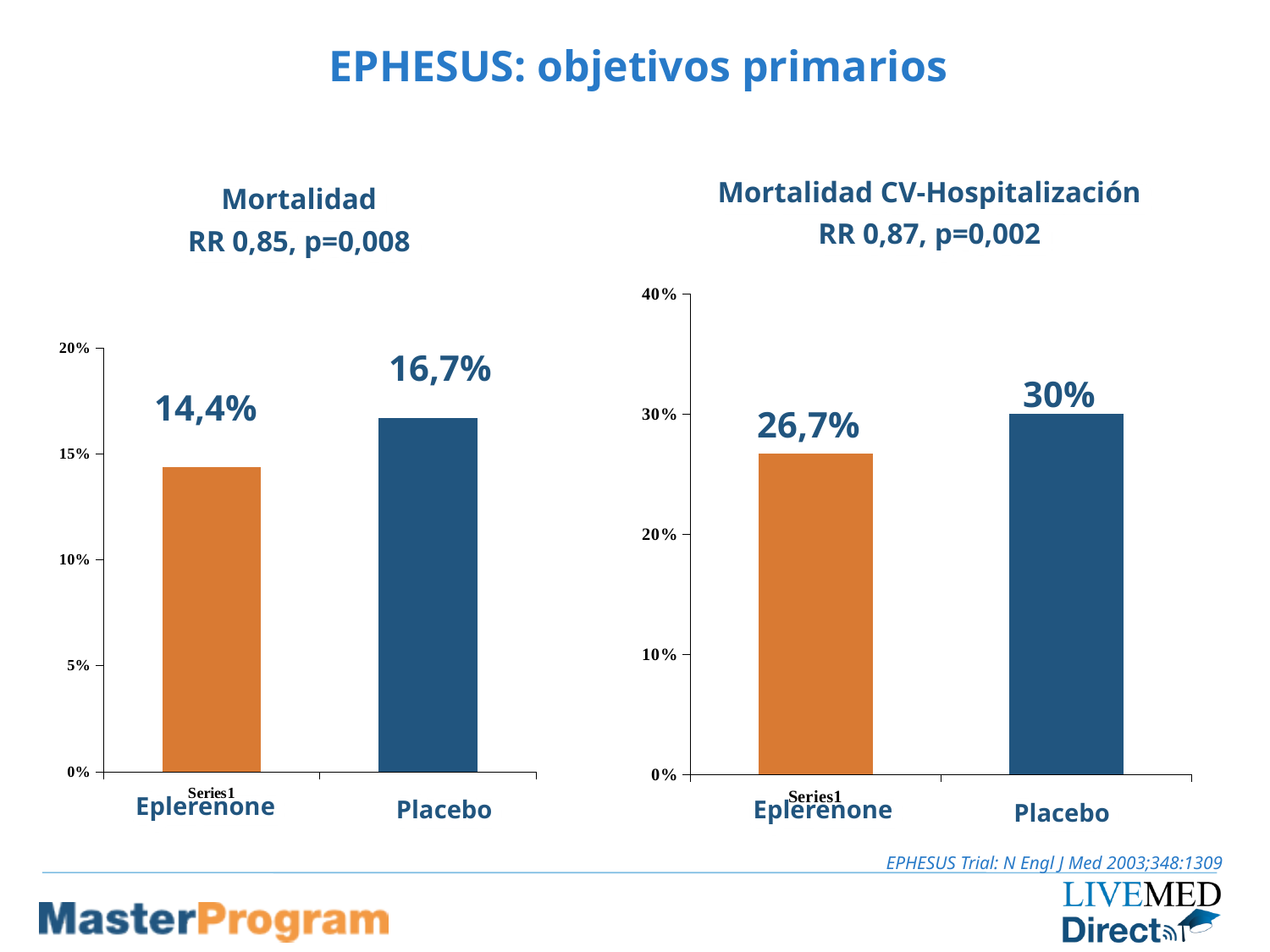
In the Mortalidad chart on the left, what is the difference between the Placebo and Eplerenone values? 2,3% In the Mortalidad CV-Hospitalización chart on the right, which category has the lower value? Eplerenone In the Mortalidad CV-Hospitalización chart on the right, what is the value for Eplerenone? 26,7% How many bars are shown in the Mortalidad chart on the left? 2 What type of chart is the Mortalidad CV-Hospitalización chart on the right? bar chart In the Mortalidad chart on the left, what is the value for Eplerenone? 14,4% In the Mortalidad CV-Hospitalización chart on the right, what is the difference between the Placebo and Eplerenone values? 3,3% In the Mortalidad CV-Hospitalización chart on the right, is the value for Eplerenone greater or less than 20%? greater In the Mortalidad chart on the left, what is the value for Placebo? 16,7% In the Mortalidad chart on the left, which category has the higher value? Placebo What is the title of the chart on the right? Mortalidad CV-Hospitalización In the Mortalidad CV-Hospitalización chart on the right, what is the value for Placebo? 30%